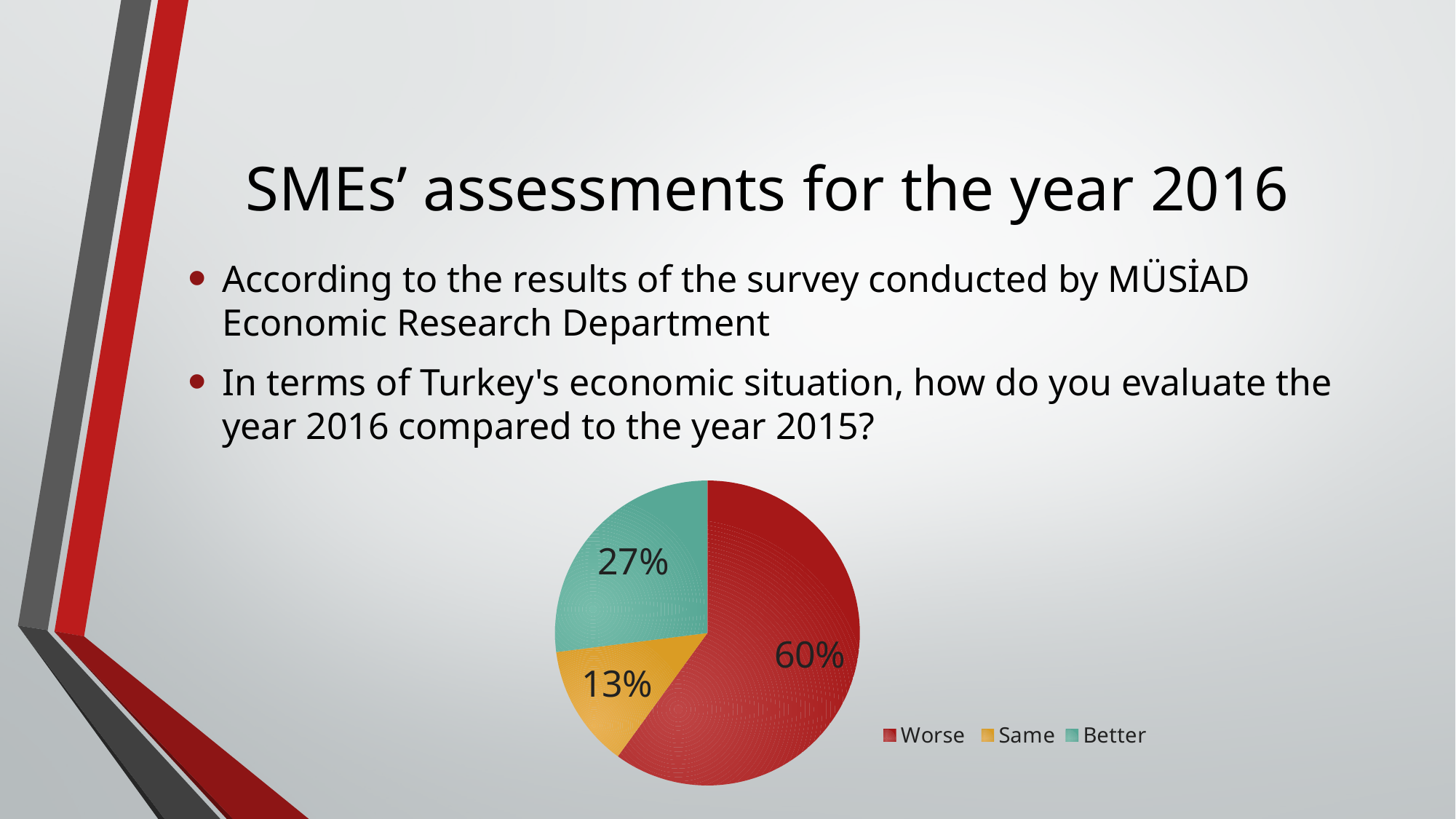
What percentage of SMEs evaluated 2016 as worse than 2015? 60% How many entries does the legend list? 3 How many slices does the pie chart have? 3 What is the difference in percentage points between the Better and Same slices? 14 What colour is the Same slice in the pie chart? orange/yellow Which slice is larger, Better or Same? Better What is the difference in percentage points between the Worse and Better slices? 33 What percentage of SMEs evaluated 2016 as the same as 2015? 13% What kind of chart is shown on the slide? pie chart Which response has the largest share of the pie? Worse What percentage of SMEs evaluated 2016 as better than 2015? 27% Which response has the smallest share of the pie? Same